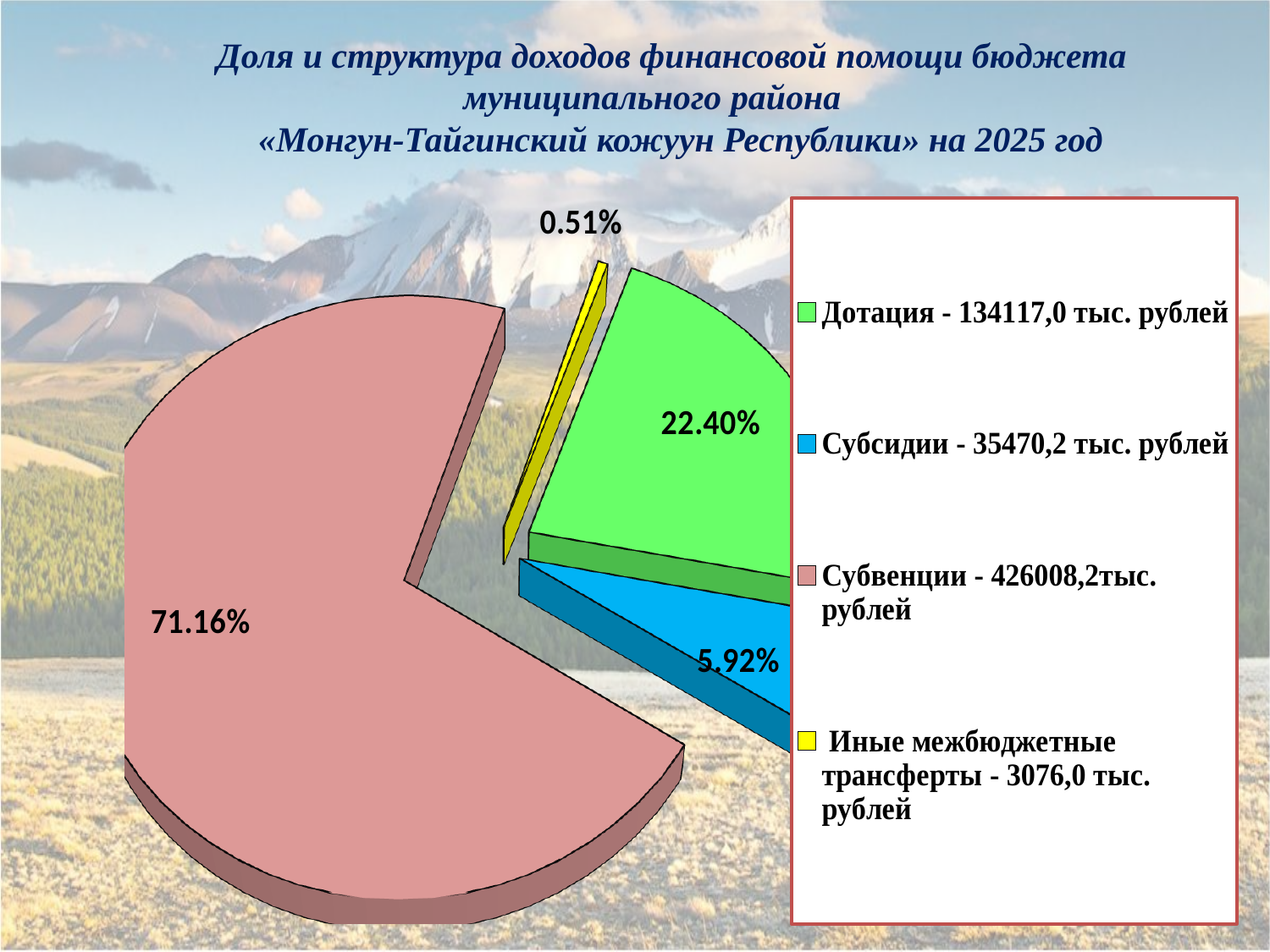
What colour is the slice for Иные межбюджетные трансферты? Yellow What is the difference in percentage points between the Субвенции share and the Дотация share? 48.76% Which category has the smallest slice of the pie? Иные межбюджетные трансферты What share of the pie does Иные межбюджетные трансферты account for? 0.51% According to the legend, what is the amount for Субсидии? 35470,2 тыс. рублей How many slices does the pie chart have? 4 Which category has the largest slice of the pie? Субвенции What share of the pie does Дотация account for? 22.40% What share of the pie does Субвенции account for? 71.16% Which is larger, the share for Дотация or the share for Субсидии? Дотация What kind of chart is shown on the slide? Pie chart